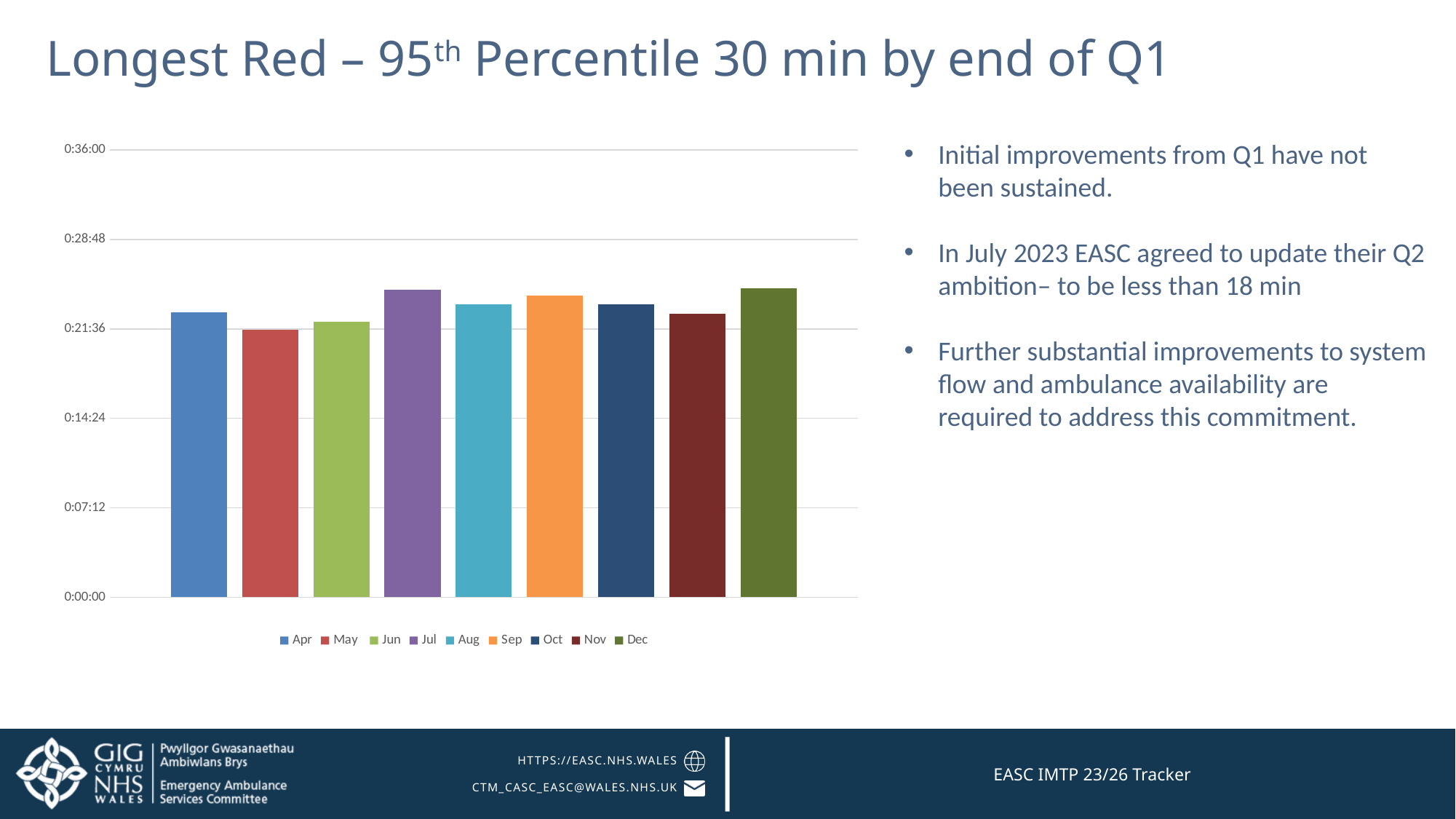
Is the value for Apr greater or less than 0:21:36? greater Which month has the lowest bar in the chart? May What is the title of the slide containing the chart? Longest Red – 95th Percentile 30 min by end of Q1 Which is larger, the value for Sep or the value for Nov? Sep Which is larger, the value for Jul or the value for May? Jul Is the value for May greater or less than 0:28:48? less How many entries does the chart legend list? 9 Is the value for Dec greater or less than 0:28:48? less Which is larger, the value for Dec or the value for Jun? Dec How many bars are plotted in the chart? 9 What kind of chart is shown on the slide? bar chart